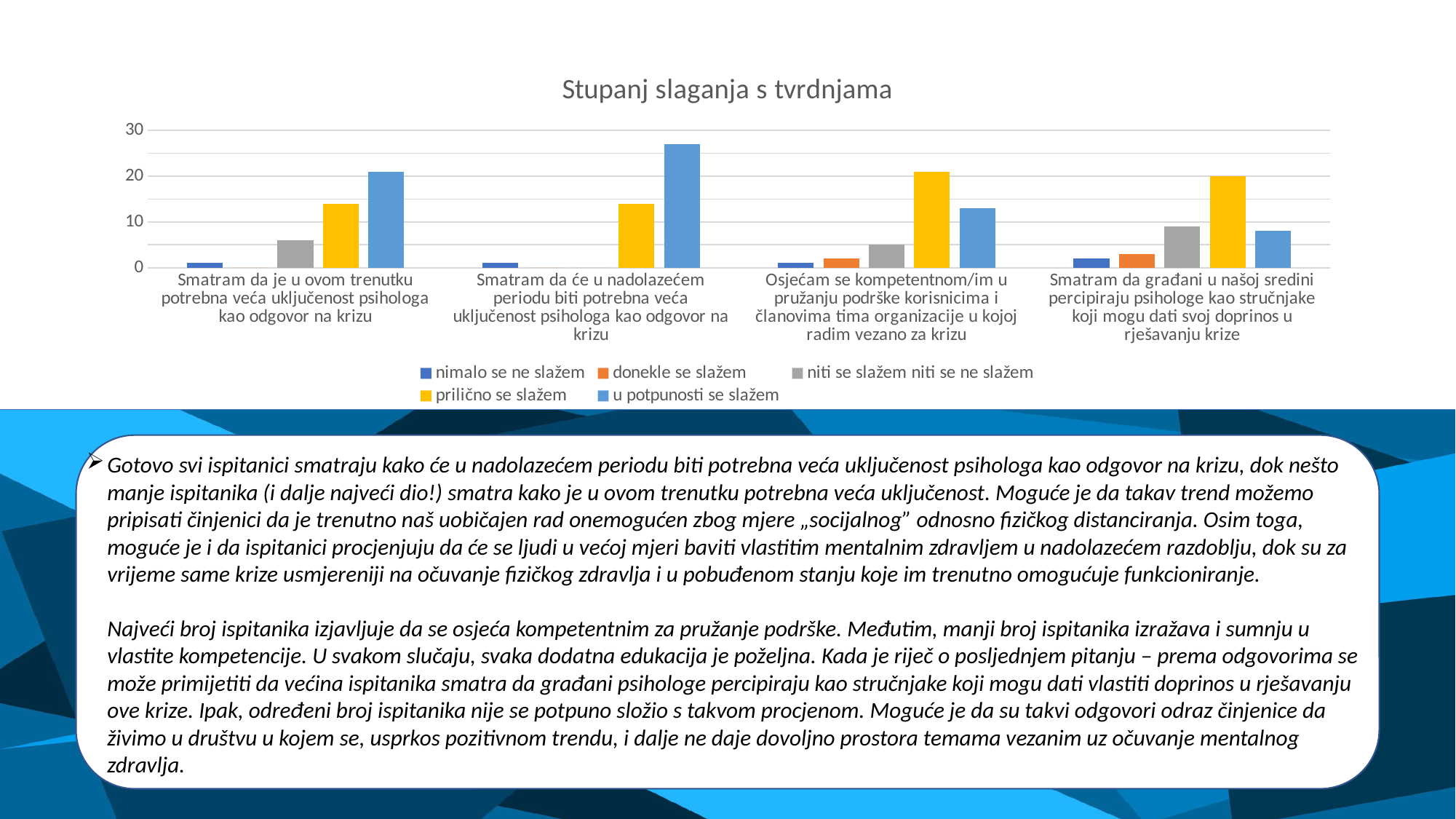
Is the "u potpunosti se slažem" value for the statement "Smatram da će u nadolazećem periodu biti potrebna veća uključenost psihologa kao odgovor na krizu" greater or less than 20? greater How many series does the chart legend list? 5 What is the title of the chart? Stupanj slaganja s tvrdnjama How many statements (categories) are shown on the x axis of the chart? 4 What kind of chart is shown on the slide? bar chart For the statement "Smatram da će u nadolazećem periodu biti potrebna veća uključenost psihologa kao odgovor na krizu", which response series has the highest bar? u potpunosti se slažem For the statement "Smatram da je u ovom trenutku potrebna veća uključenost psihologa kao odgovor na krizu", which is larger: "prilično se slažem" or "u potpunosti se slažem"? u potpunosti se slažem Is the "u potpunosti se slažem" value for the statement "Osjećam se kompetentnom/im u pružanju podrške korisnicima i članovima tima organizacije u kojoj radim vezano za krizu" greater or less than 10? greater For which statement is the "u potpunosti se slažem" bar the highest? Smatram da će u nadolazećem periodu biti potrebna veća uključenost psihologa kao odgovor na krizu For the statement "Osjećam se kompetentnom/im u pružanju podrške korisnicima i članovima tima organizacije u kojoj radim vezano za krizu", which response series has the highest bar? prilično se slažem Is the "niti se slažem niti se ne slažem" value for the statement "Smatram da je u ovom trenutku potrebna veća uključenost psihologa kao odgovor na krizu" greater or less than 10? less For the statement "Smatram da građani u našoj sredini percipiraju psihologe kao stručnjake koji mogu dati svoj doprinos u rješavanju krize", which is larger: "prilično se slažem" or "u potpunosti se slažem"? prilično se slažem